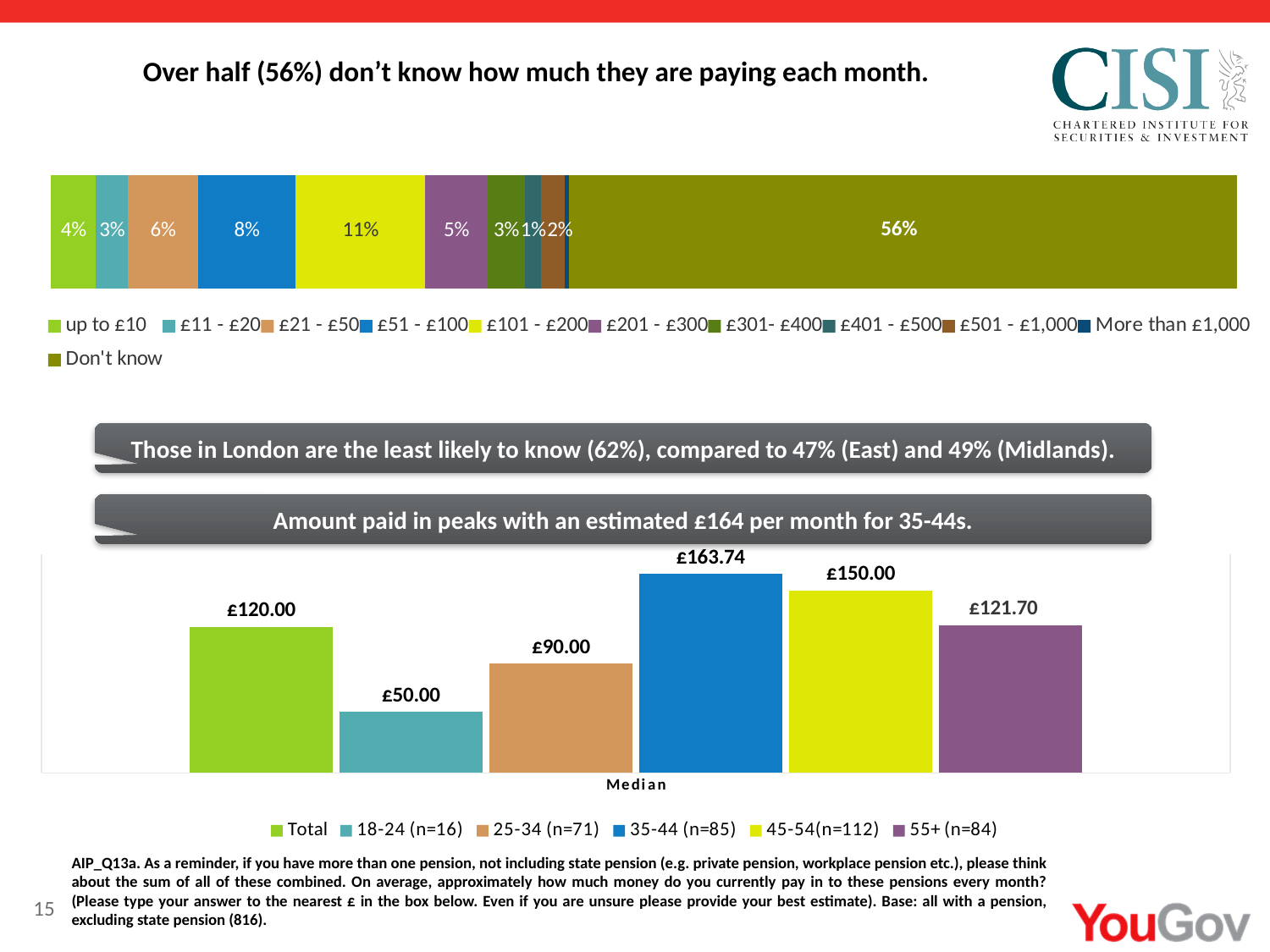
In the top stacked bar chart, what percentage pay £51 - £100 per month? 8% In the top stacked bar chart, what is the difference between the £101 - £200 segment and the £201 - £300 segment? 6% What kind of chart is the bottom 'Median' chart? Bar chart In the bottom 'Median' chart, which group has the lowest median amount? 18-24 (n=16) In the top stacked bar chart, what percentage pay £101 - £200 per month? 11% In the top stacked bar chart, what percentage of respondents answered 'Don't know'? 56% In the bottom 'Median' chart, what is the median amount for 18-24 (n=16)? £50.00 In the bottom 'Median' chart, which is larger: the median for 45-54 (n=112) or for 55+ (n=84)? 45-54 (n=112) In the bottom 'Median' chart, what is the median amount for 35-44 (n=85)? £163.74 In the top stacked bar chart, how many entries does the legend list? 11 In the bottom 'Median' chart, what is the difference between the Total median and the 25-34 (n=71) median? £30.00 In the top stacked bar chart, which segment is the largest? Don't know